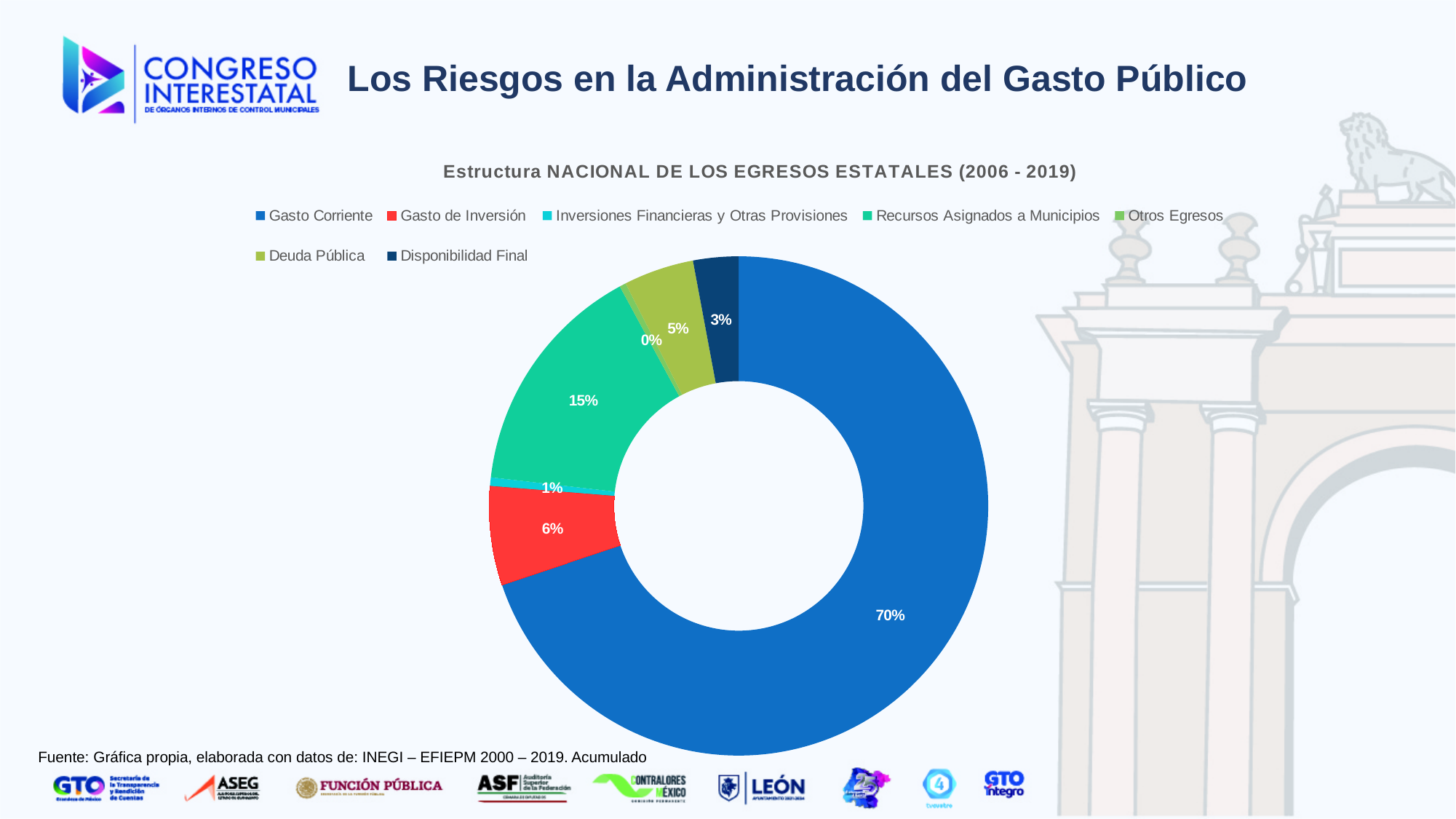
What type of chart is shown on the slide? Doughnut (pie) chart What percentage is shown for Gasto de Inversión? 6% Which category has the smallest share, labelled 0%? Otros Egresos What share of the chart does Gasto Corriente represent? 70% Which category has the largest share of the chart? Gasto Corriente How many categories does the legend list? 7 What is the difference in percentage points between Gasto Corriente and Recursos Asignados a Municipios? 55 What percentage is shown for Disponibilidad Final? 3% What percentage is shown for Deuda Pública? 5% What is the title of the chart? Estructura NACIONAL DE LOS EGRESOS ESTATALES (2006 - 2019) What percentage is shown for Recursos Asignados a Municipios? 15% Which is larger, the share for Gasto de Inversión or the share for Deuda Pública? Gasto de Inversión